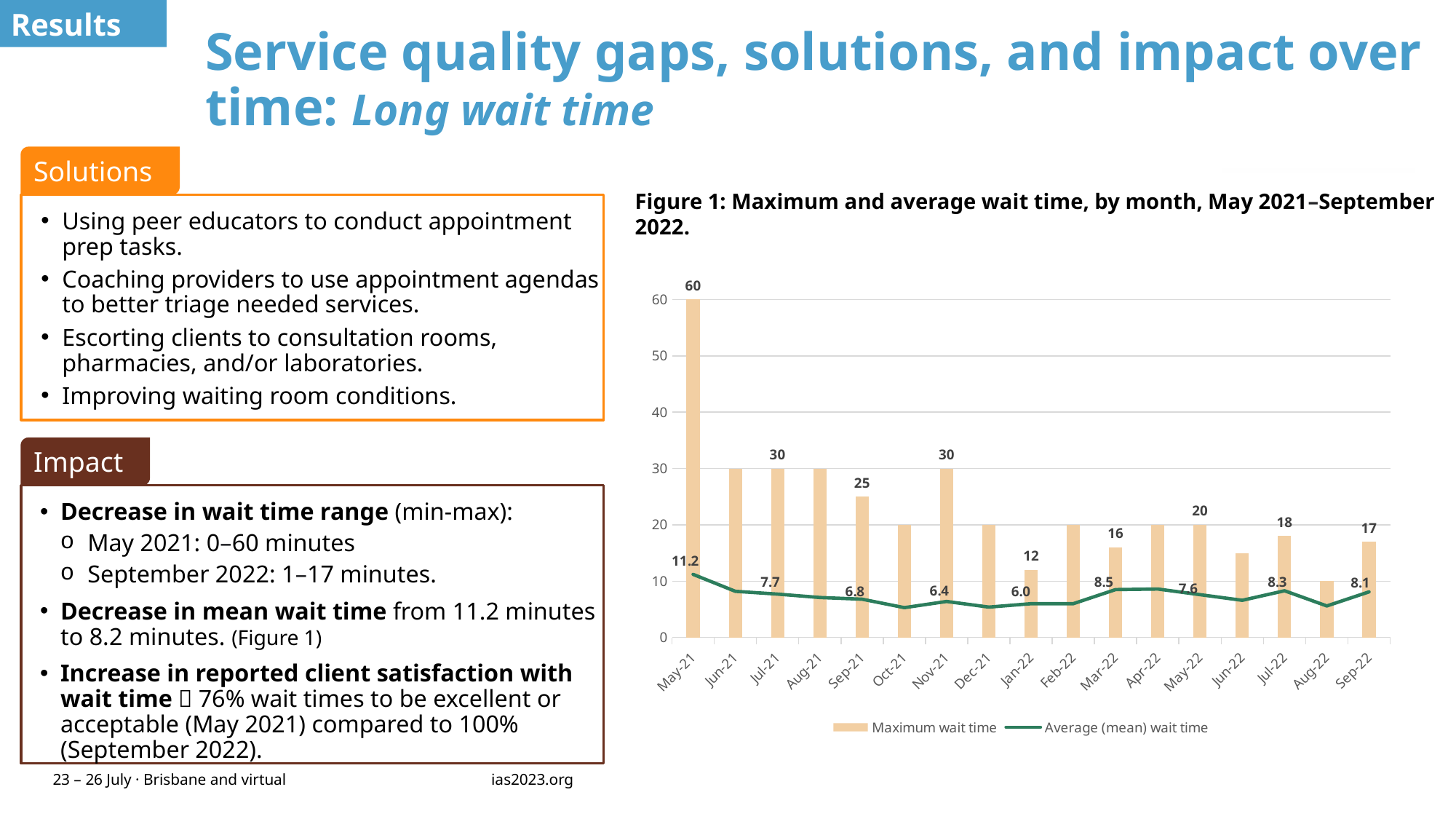
What is the maximum wait time for May-21? 60 What is the maximum wait time for Nov-21? 30 What kind of chart is Figure 1? Combination bar and line chart What is the difference between the maximum wait time in May-21 and in Sep-22? 43 Which month has the highest maximum wait time? May-21 Which month has a larger maximum wait time, Sep-21 or Jan-22? Sep-21 How many series does the legend list? 2 Is the maximum wait time for Aug-22 greater or less than 20? less How many months are shown on the x axis? 17 Which month has the highest average (mean) wait time? May-21 What is the difference between the average wait time in May-21 and in Sep-22? 3.1 What is the average (mean) wait time for Jan-22? 6.0